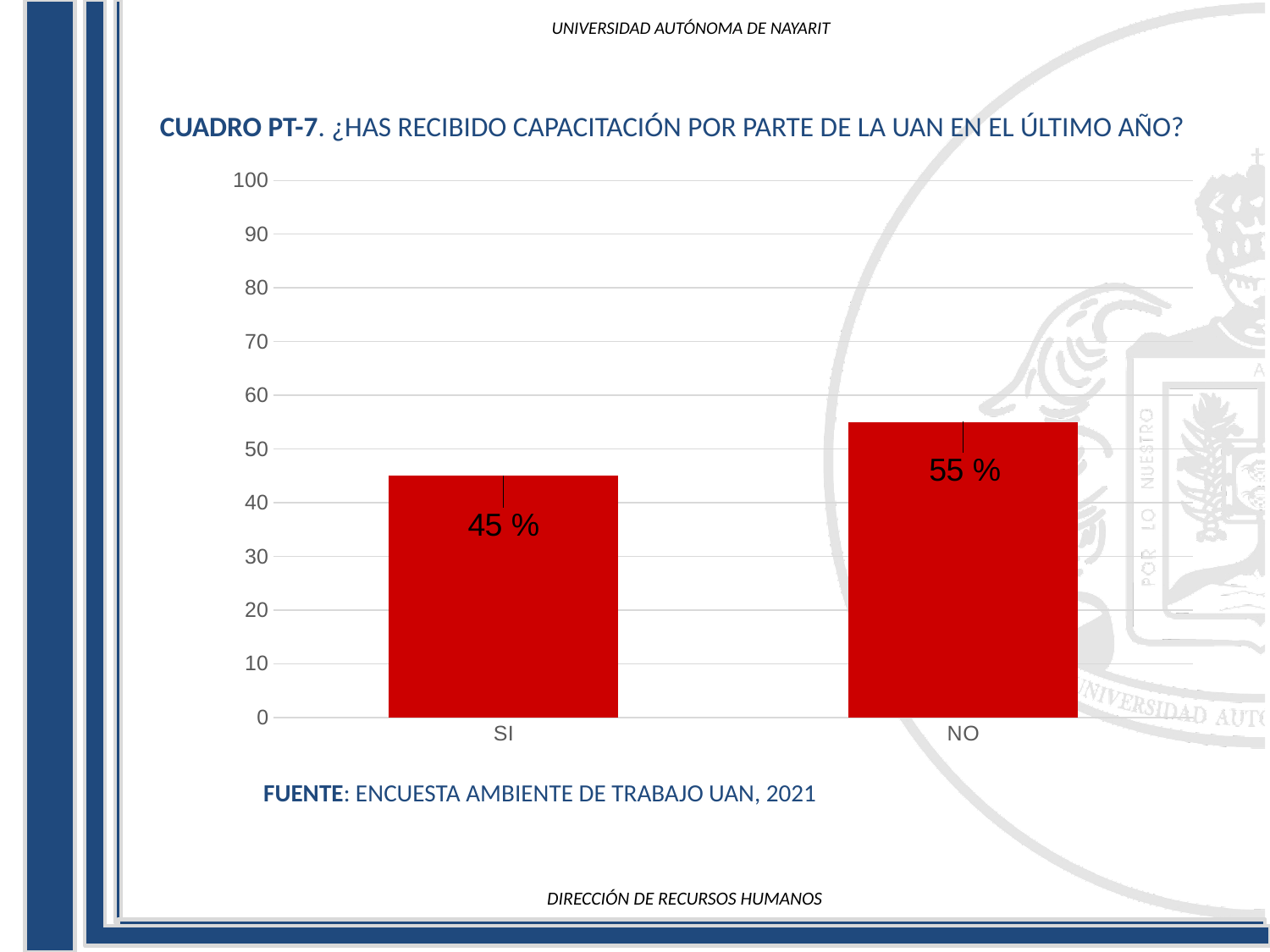
How many categories are shown on the x axis? 2 Which category has the highest value? NO What is the value for NO? 55 % Which category has the lowest value? SI What is the difference between the values for NO and SI? 10 % What colour are the bars in the chart? red What kind of chart is shown on the slide? bar chart Is the value for SI greater or less than 50? less What is the maximum value shown on the y axis? 100 What is the value for SI? 45 % Which is larger, the value for SI or the value for NO? NO Is the value for NO greater or less than 50? greater